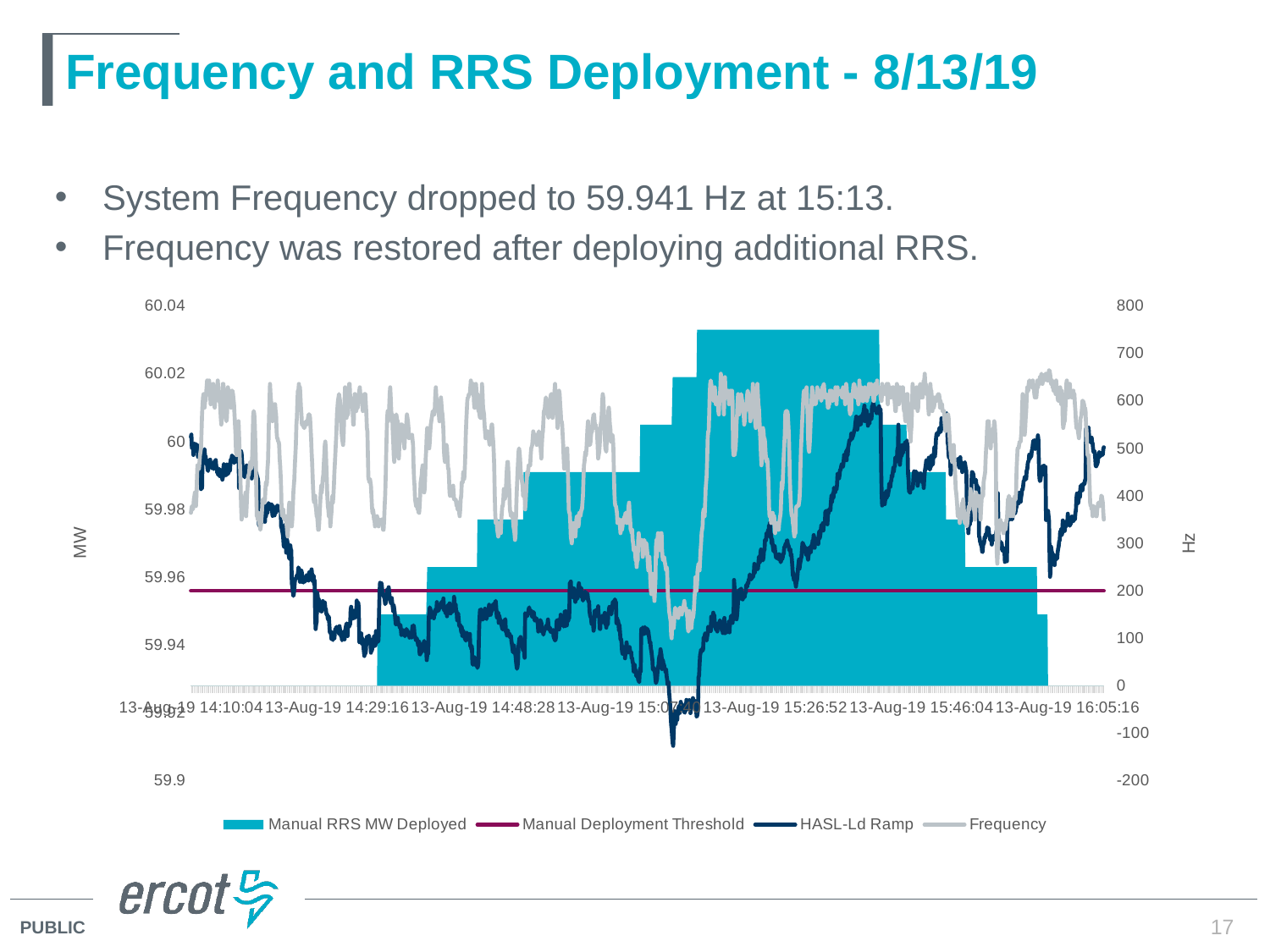
How many time labels are shown along the x axis of the chart? 7 What is the first time label shown on the x axis of the chart? 13-Aug-19 14:10:04 What are the labels of the left and right vertical axes of the chart? MW (left) and Hz (right) Is the peak of the Manual RRS MW Deployed area greater or less than 700 on the right-hand axis? greater What is the lowest value shown on the right-hand vertical axis of the chart? -200 What is the highest value shown on the left-hand vertical axis of the chart? 60.04 Does the Manual RRS MW Deployed area rise or fall from its peak around 15:26 to the end of the chart? fall Is the peak of the Manual RRS MW Deployed area greater or less than 800 on the right-hand axis? less Does the Manual RRS MW Deployed area rise or fall from the start of the chart to its peak around 15:26? rise Which series in the chart is drawn as a filled area? Manual RRS MW Deployed What kind of chart is shown on the slide? Combination area and line chart How many series does the chart legend list? 4